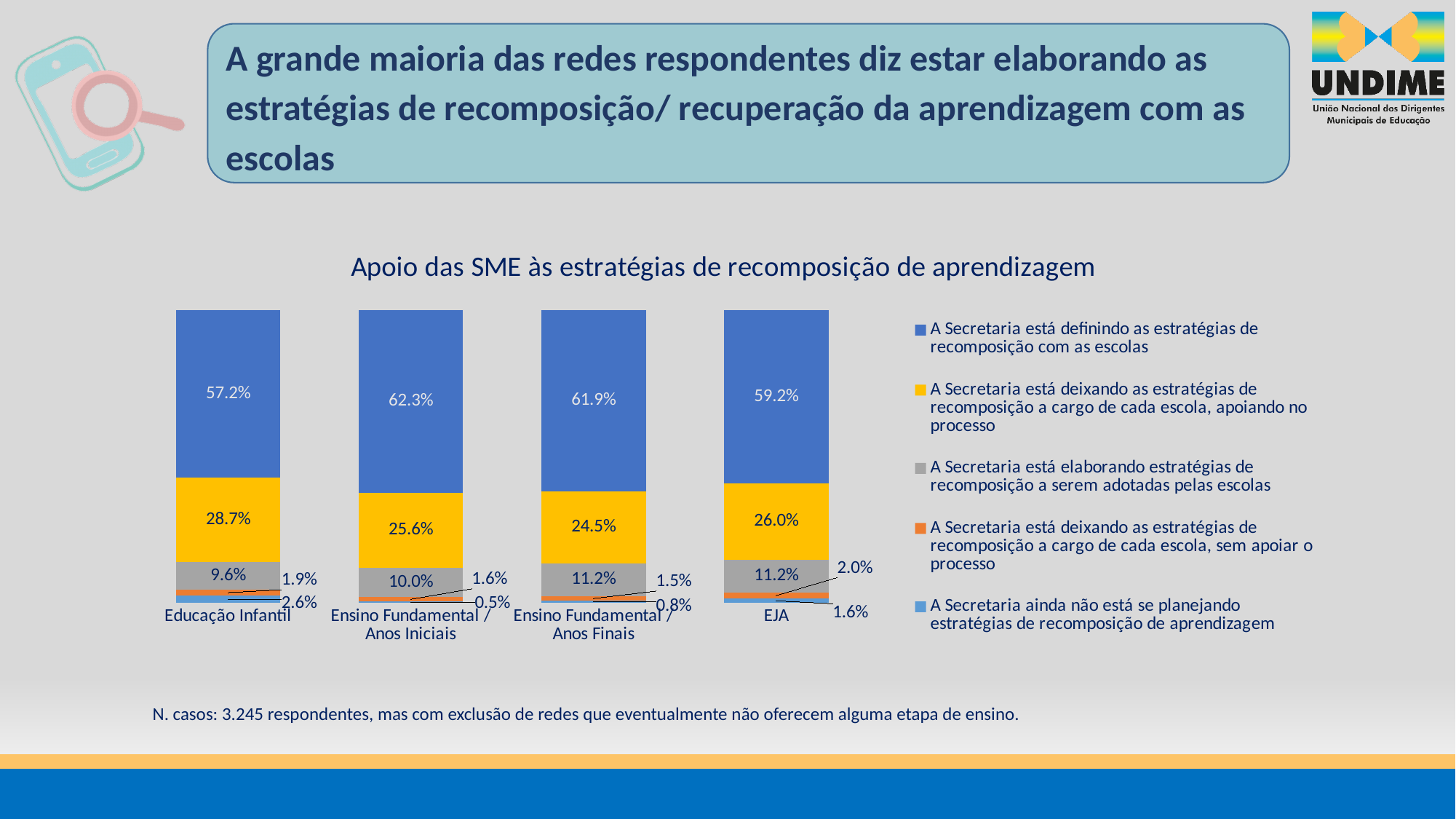
What is the difference between the 'definindo as estratégias com as escolas' values for Ensino Fundamental / Anos Iniciais and Educação Infantil? 5.1 percentage points Which is larger: the 'a cargo de cada escola, apoiando no processo' value for Educação Infantil or for Ensino Fundamental / Anos Finais? Educação Infantil What is the title of the chart? Apoio das SME às estratégias de recomposição de aprendizagem How many categories (education stages) are shown on the x axis of the chart? 4 Which category has the highest value for 'A Secretaria está definindo as estratégias de recomposição com as escolas'? Ensino Fundamental / Anos Iniciais What percentage of respondents for Ensino Fundamental / Anos Iniciais said the Secretaria is defining the recomposition strategies with the schools? 62.3% What type of chart is shown on the slide? Stacked bar chart What is the value for 'A Secretaria está elaborando estratégias de recomposição a serem adotadas pelas escolas' for EJA? 11.2% Which colour represents 'A Secretaria ainda não está se planejando estratégias de recomposição de aprendizagem' in the legend? Light blue Which category has the lowest value for 'A Secretaria está definindo as estratégias de recomposição com as escolas'? Educação Infantil How many series does the chart legend list? 5 What is the value for 'A Secretaria está deixando as estratégias de recomposição a cargo de cada escola, apoiando no processo' for Educação Infantil? 28.7%